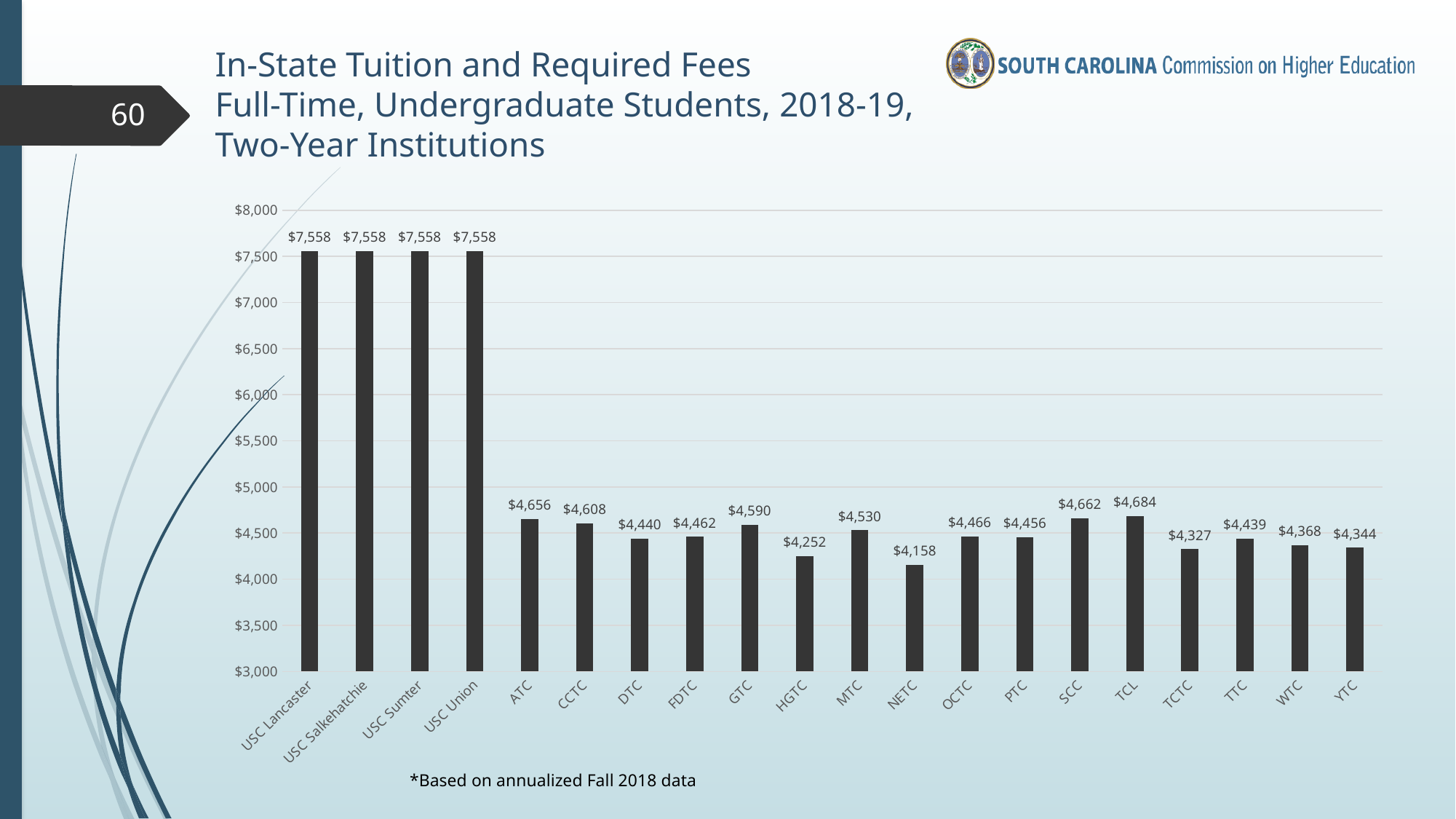
Which has a larger value, SCC or GTC? SCC Which institution has the lowest in-state tuition and required fees on the chart? NETC What kind of chart is shown on the slide? Bar chart What is the difference between the values for USC Lancaster and ATC? $2,902 Excluding the four USC campuses, which institution has the highest value on the chart? TCL What is the value shown for NETC? $4,158 Is the value for HGTC greater or less than $4,500? less According to the footnote, what data is the chart based on? Annualized Fall 2018 data What is the value shown for USC Sumter? $7,558 How many institutions are shown on the chart? 20 What is the difference between the values for TCL and NETC? $526 What is the in-state tuition and required fees value for ATC? $4,656